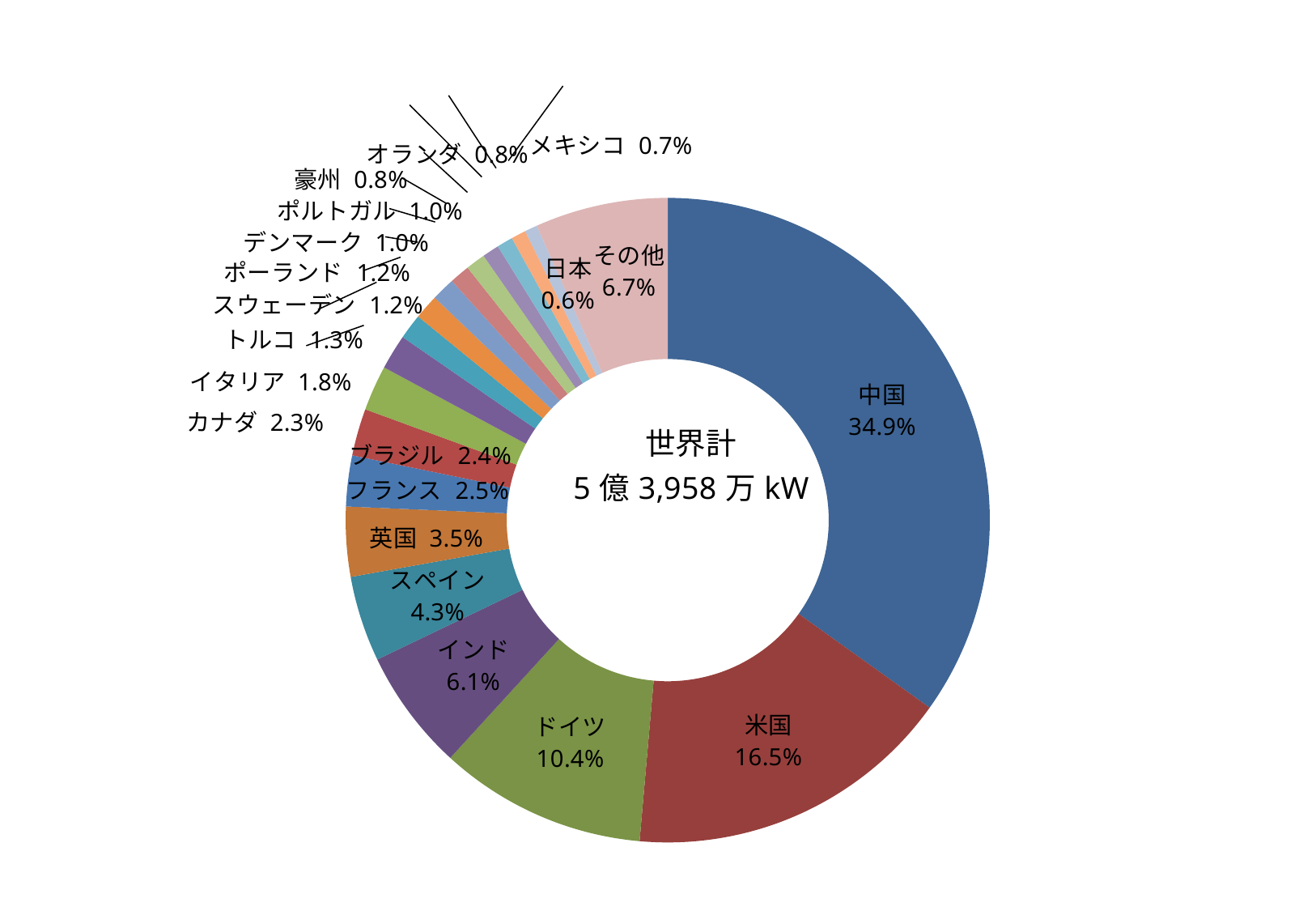
How many slices (categories) does the chart have, including その他? 20 Which is larger, the share for インド or the share for スペイン? インド What is the value shown for 米国 (United States)? 16.5% What kind of chart is shown on the slide? Doughnut (pie) chart Which country has the largest slice in the chart? 中国 What is the value shown for 日本 (Japan)? 0.6% What is the value shown for ドイツ (Germany)? 10.4% What share of the chart does 中国 (China) account for? 34.9% Which named country has the smallest slice in the chart? 日本 What world total is printed in the centre of the chart? 5億3,958万kW What is the difference between the shares of 英国 and フランス? 1.0% What is the difference between the shares of 中国 and 米国? 18.4%